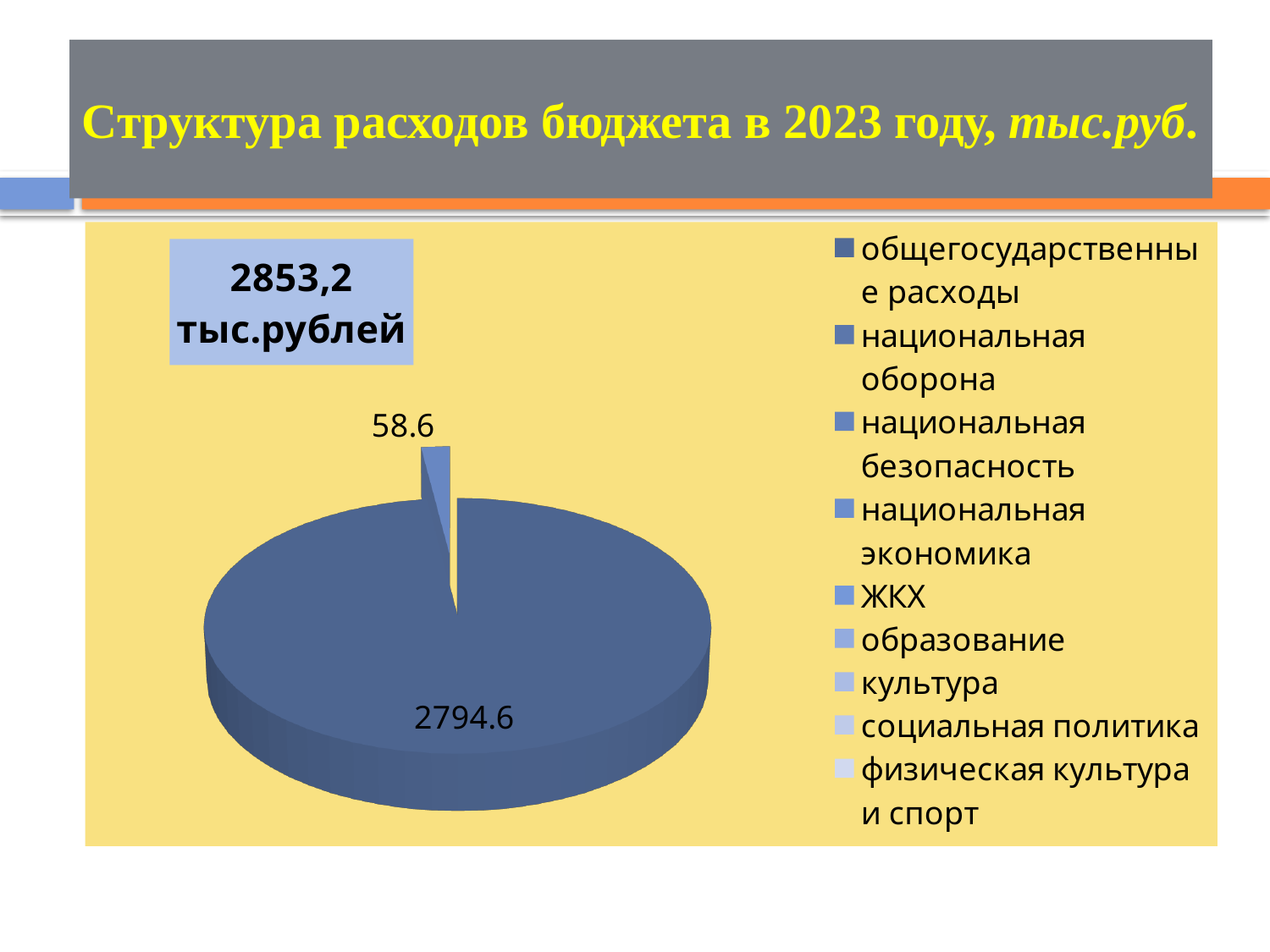
How many slices of the pie chart have a data label printed? 2 How many entries does the legend of the pie chart list? 9 Which legend entry is listed first in the pie chart's legend? общегосударственные расходы What is the total of the two labelled slices, 2794.6 and 58.6? 2853.2 What is the value of the largest slice of the pie chart? 2794.6 What is the value of the small slice labelled at the top of the pie chart? 58.6 Which labelled slice is larger: the one labelled 2794.6 or the one labelled 58.6? 2794.6 What share of the pie does the slice labelled 58.6 represent, given the total of 2853.2? 2.1% What is the difference between the two labelled slices, 2794.6 and 58.6? 2736 What total amount is shown in the box at the top left of the chart area? 2853,2 тыс.рублей What kind of chart is shown on the slide? pie chart What is the title of the slide containing the pie chart? Структура расходов бюджета в 2023 году, тыс.руб.